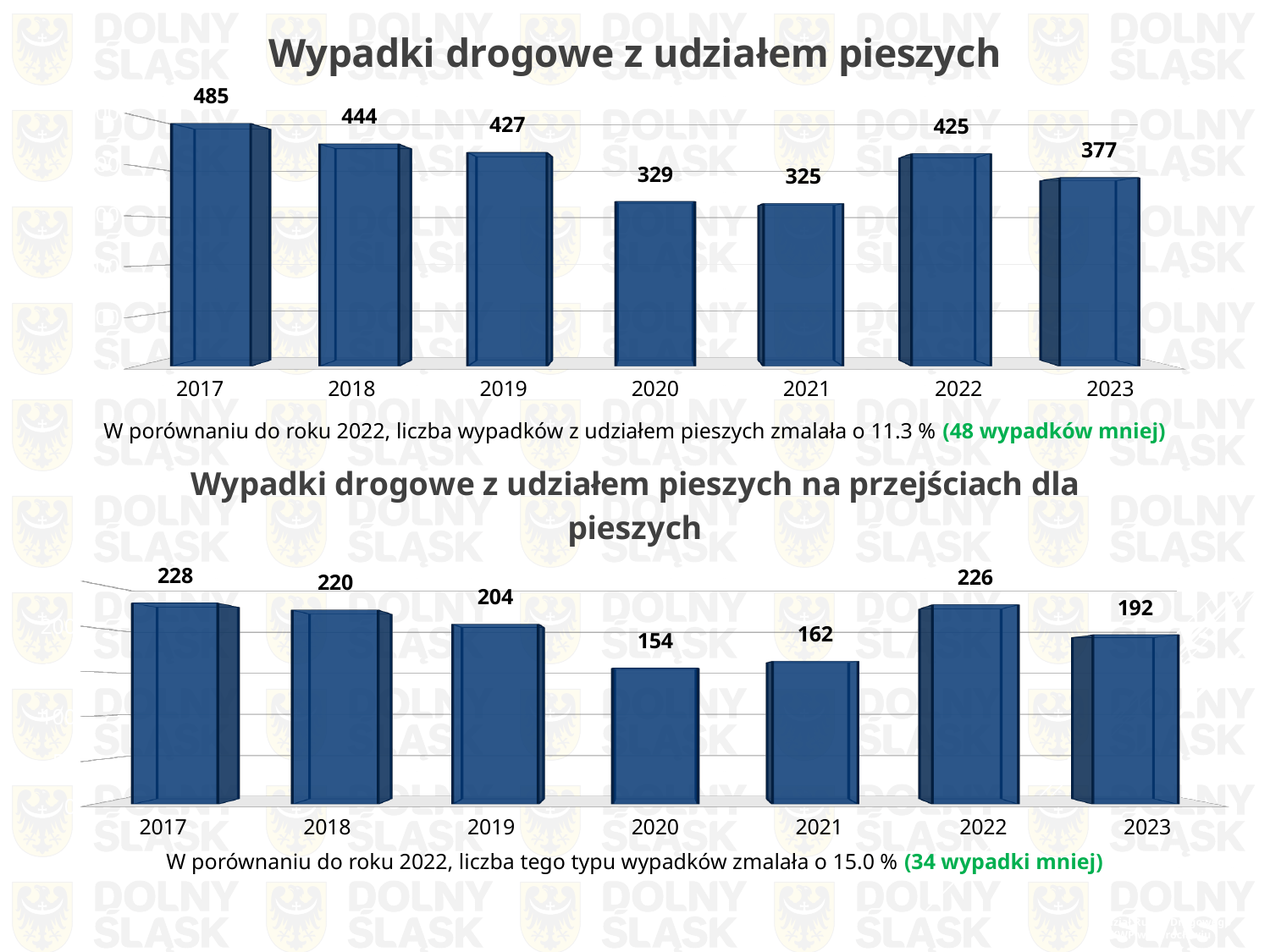
In the chart 'Wypadki drogowe z udziałem pieszych', what is the difference between the values for 2022 and 2023? 48 In the chart 'Wypadki drogowe z udziałem pieszych na przejściach dla pieszych', do the values rise or fall from 2017 to 2020? fall In the chart 'Wypadki drogowe z udziałem pieszych na przejściach dla pieszych', which year has the highest value? 2017 In the chart 'Wypadki drogowe z udziałem pieszych', which is larger, the value for 2019 or the value for 2022? 2019 In the chart 'Wypadki drogowe z udziałem pieszych', what is the value for 2017? 485 In the chart 'Wypadki drogowe z udziałem pieszych na przejściach dla pieszych', what is the value for 2020? 154 How many years are shown in the chart 'Wypadki drogowe z udziałem pieszych'? 7 What kind of chart is 'Wypadki drogowe z udziałem pieszych'? bar chart In the chart 'Wypadki drogowe z udziałem pieszych', what is the value for 2021? 325 In the chart 'Wypadki drogowe z udziałem pieszych', which year has the lowest value? 2021 In the chart 'Wypadki drogowe z udziałem pieszych na przejściach dla pieszych', which is larger, the value for 2020 or the value for 2021? 2021 In the chart 'Wypadki drogowe z udziałem pieszych na przejściach dla pieszych', what is the difference between the values for 2022 and 2023? 34